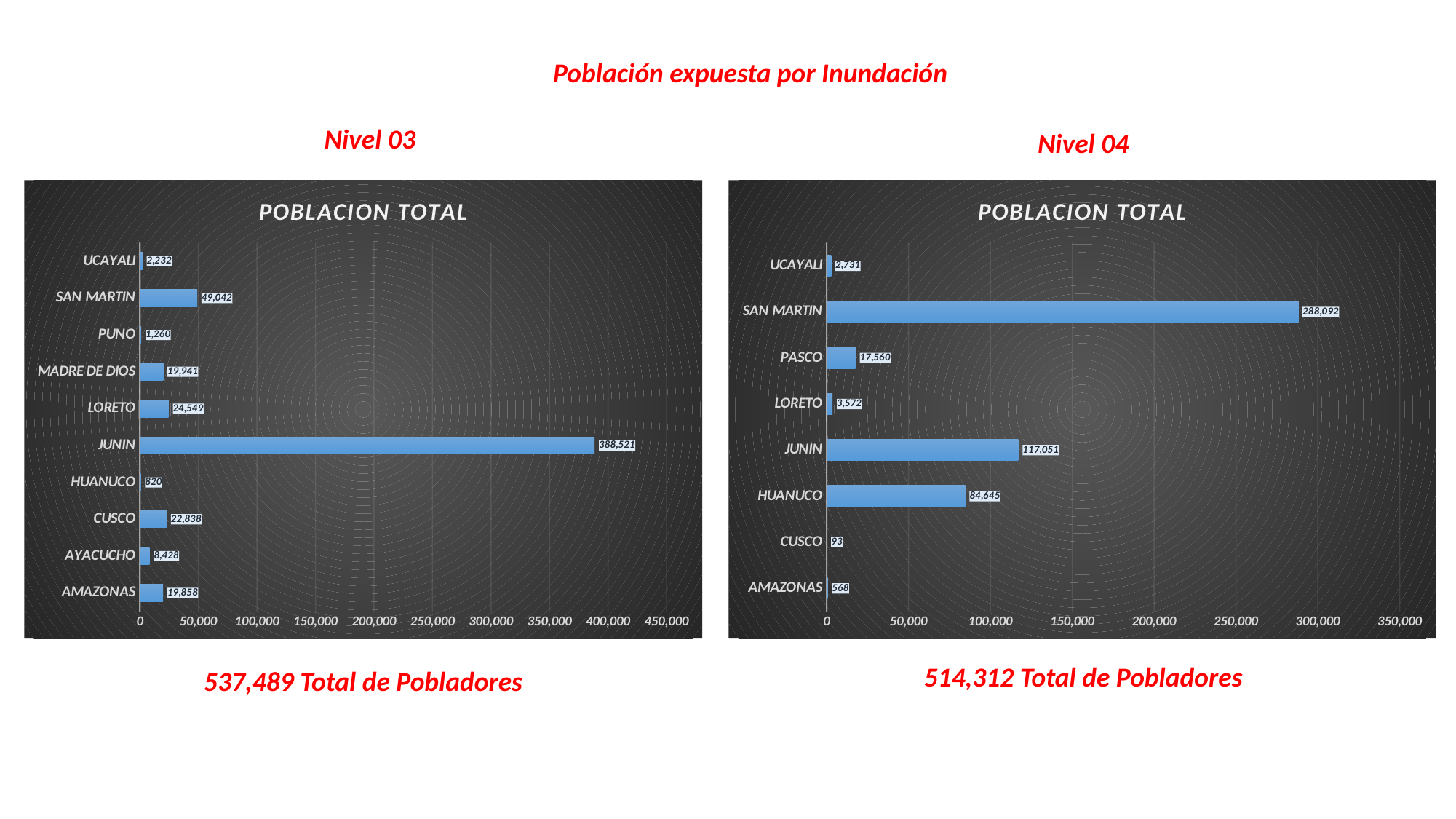
In the Nivel 04 chart, what is the value for HUANUCO? 84,645 How many categories are shown in the Nivel 03 chart? 10 In the Nivel 04 chart, which category has the highest value? SAN MARTIN In the Nivel 03 chart, which is larger, LORETO or CUSCO? LORETO What kind of chart is the Nivel 04 chart? Bar chart How many categories are shown in the Nivel 04 chart? 8 In the Nivel 04 chart, which category has the lowest value? CUSCO In the Nivel 03 chart, which category has the lowest value? HUANUCO In the Nivel 04 chart, what is the value for SAN MARTIN? 288,092 In the Nivel 04 chart, what is the difference between SAN MARTIN and JUNIN? 171,041 In the Nivel 03 chart, what is the value for JUNIN? 388,521 In the Nivel 03 chart, what is the value for MADRE DE DIOS? 19,941